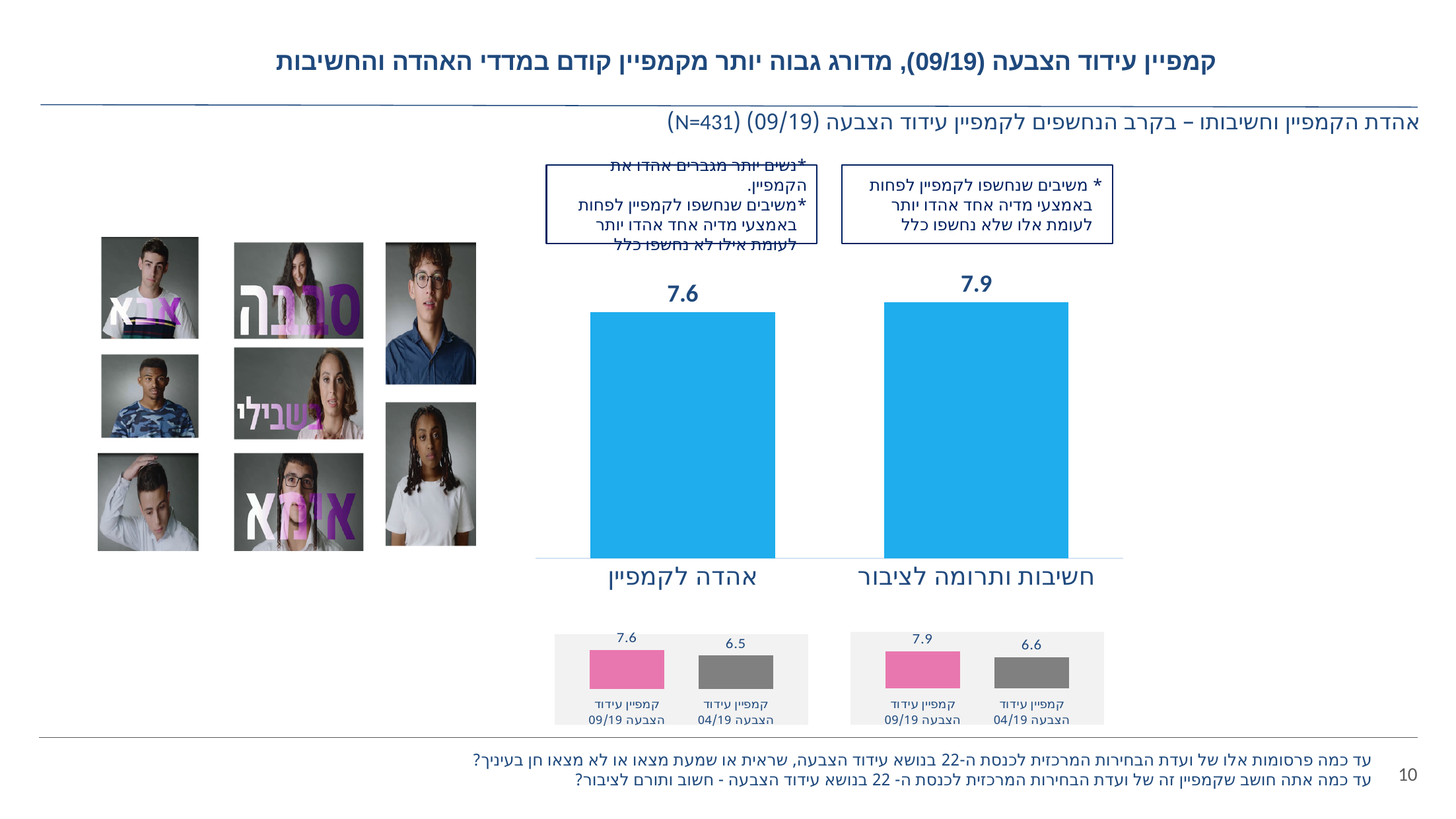
In the main bar chart, what is the difference between the values for חשיבות ותרומה לציבור and אהדה לקמפיין? 0.3 In the small chart at the bottom right (חשיבות ותרומה לציבור), which campaign has the larger value, 09/19 or 04/19? 09/19 In the small chart at the bottom left (אהדה לקמפיין), what is the difference between the 09/19 and 04/19 campaign values? 1.1 In the main bar chart, what is the value for חשיבות ותרומה לציבור? 7.9 How many bars does the main bar chart show? 2 In the main bar chart, what is the value for אהדה לקמפיין? 7.6 In the small charts at the bottom, what colour are the bars for קמפיין עידוד הצבעה 09/19? pink In the small chart at the bottom left (אהדה לקמפיין), what is the value for קמפיין עידוד הצבעה 04/19? 6.5 In the main bar chart, which category has the higher value? חשיבות ותרומה לציבור In the small chart at the bottom right (חשיבות ותרומה לציבור), what is the value for קמפיין עידוד הצבעה 04/19? 6.6 In the main bar chart, which category has the lower value? אהדה לקמפיין What kind of chart is the main chart on the slide? bar chart